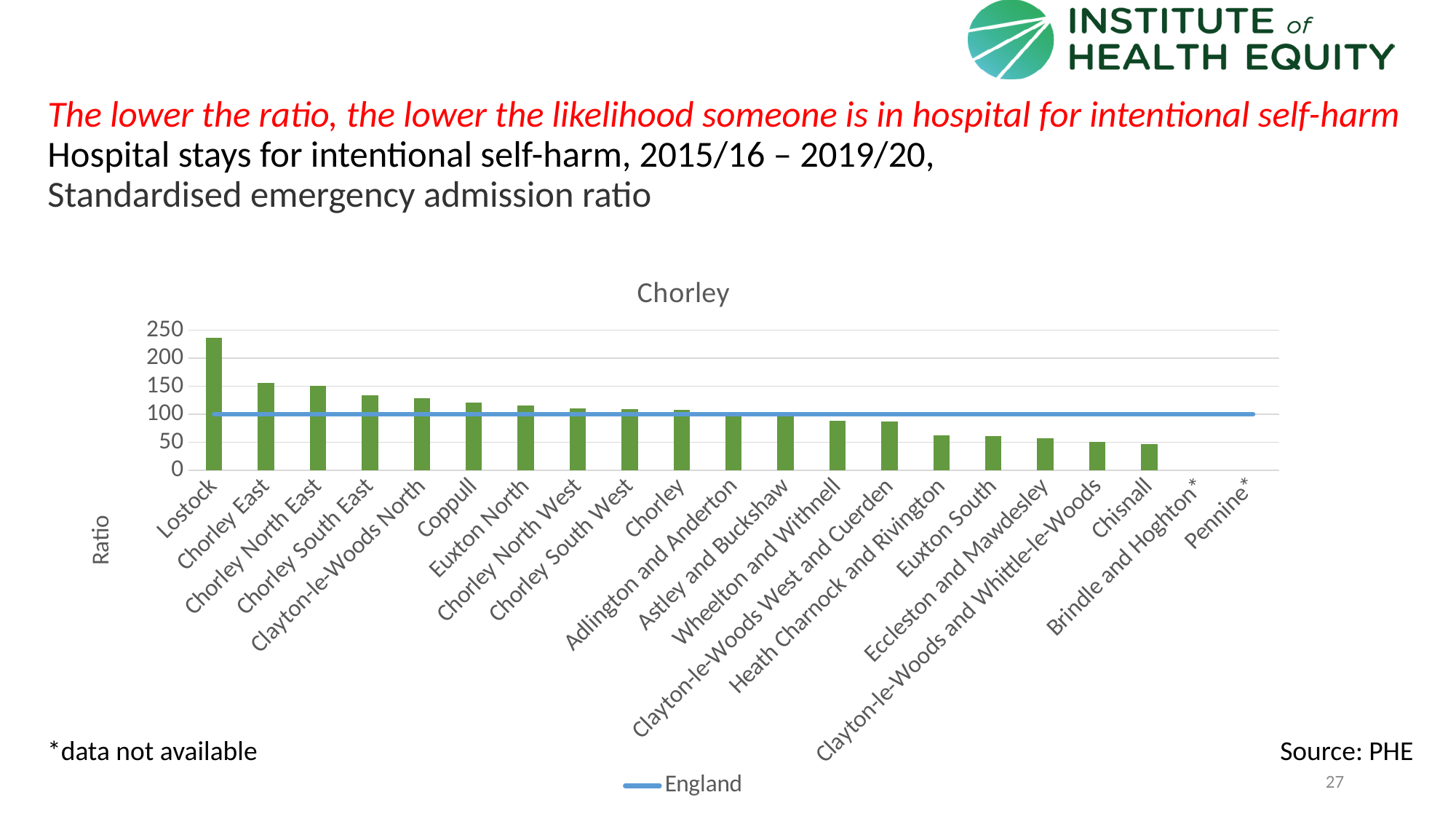
Which category has the highest ratio? Lostock Do the bar values rise or fall from left to right along the x axis? Fall Is the value for Lostock greater or less than 200? greater What does the horizontal blue line in the chart represent, according to the legend? England Is the value for Chorley North East greater or less than 100? greater Is the value for Euxton South greater or less than 100? less What kind of chart is shown on the slide? Bar chart Which is larger, the value for Lostock or the value for Chorley East? Lostock Among the categories with a bar plotted, which has the lowest ratio? Chisnall How many categories are listed on the x axis? 21 What is the title of the chart? Chorley